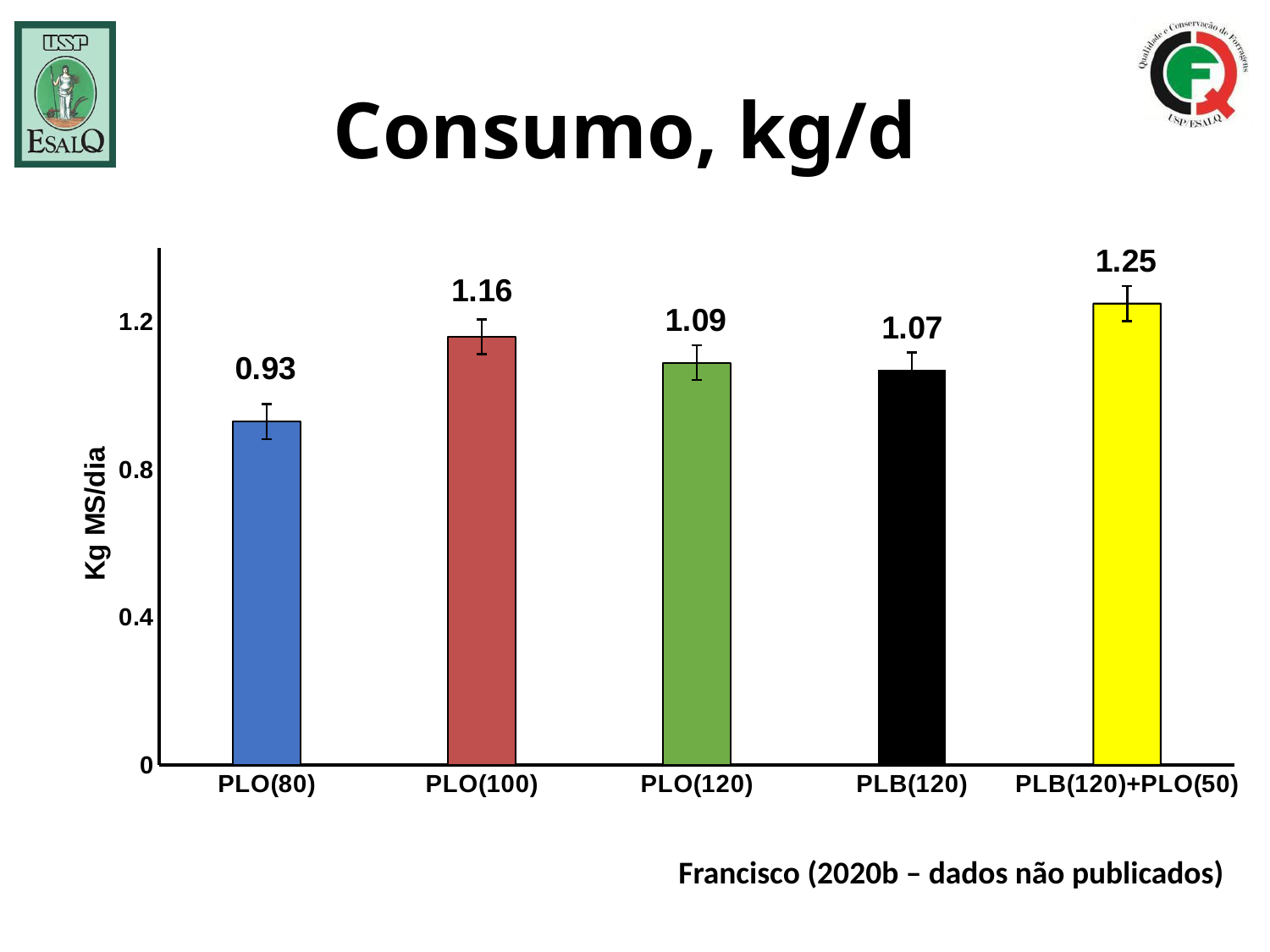
What kind of chart is shown on the slide? bar chart What is the value for PLO(120)? 1.09 Is the value for PLB(120) greater or less than 0.8? greater What is the value for PLB(120)+PLO(50)? 1.25 How many categories are shown on the x axis? 5 Which category has the highest value? PLB(120)+PLO(50) What is the value for PLO(80)? 0.93 What is the difference between the values for PLB(120)+PLO(50) and PLO(80)? 0.32 Which is larger, the value for PLO(100) or the value for PLO(80)? PLO(100) Which category has the lowest value? PLO(80) What is the difference between the values for PLO(100) and PLB(120)? 0.09 What is the label of the y axis? Kg MS/dia